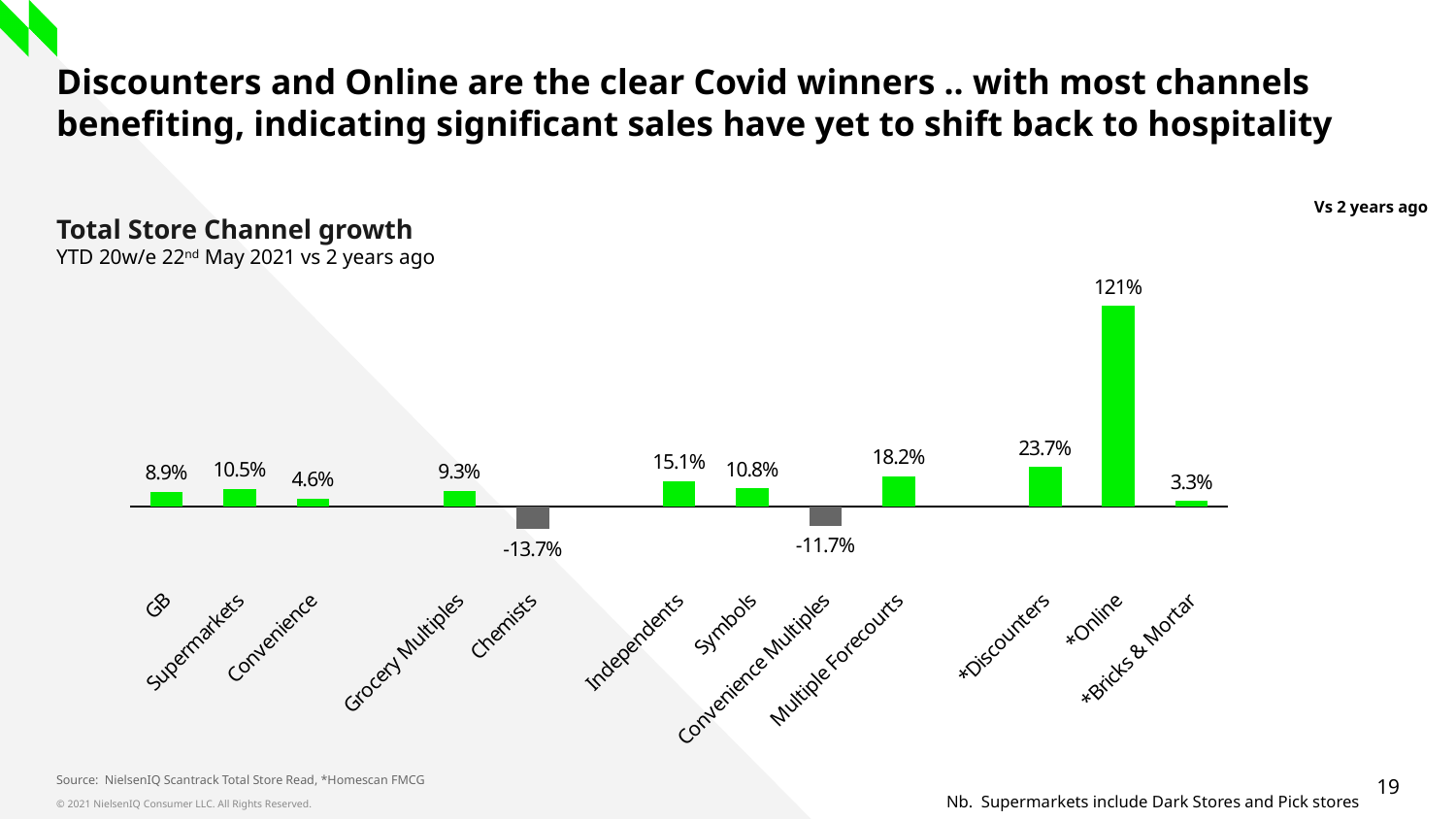
What is the growth value for Chemists? -13.7% What is the growth value for *Online? 121% What is the difference between the growth for *Discounters and the growth for *Bricks & Mortar? 20.4 percentage points How many channels show negative growth? 2 What is the growth value for Supermarkets? 10.5% What kind of chart is shown on the slide? Bar chart What is the title of the chart? Total Store Channel growth What is the growth value for Multiple Forecourts? 18.2% How many channels are shown in the chart? 12 Which channel has the highest growth? *Online Which has higher growth, Independents or Symbols? Independents Which channel has the lowest growth? Chemists